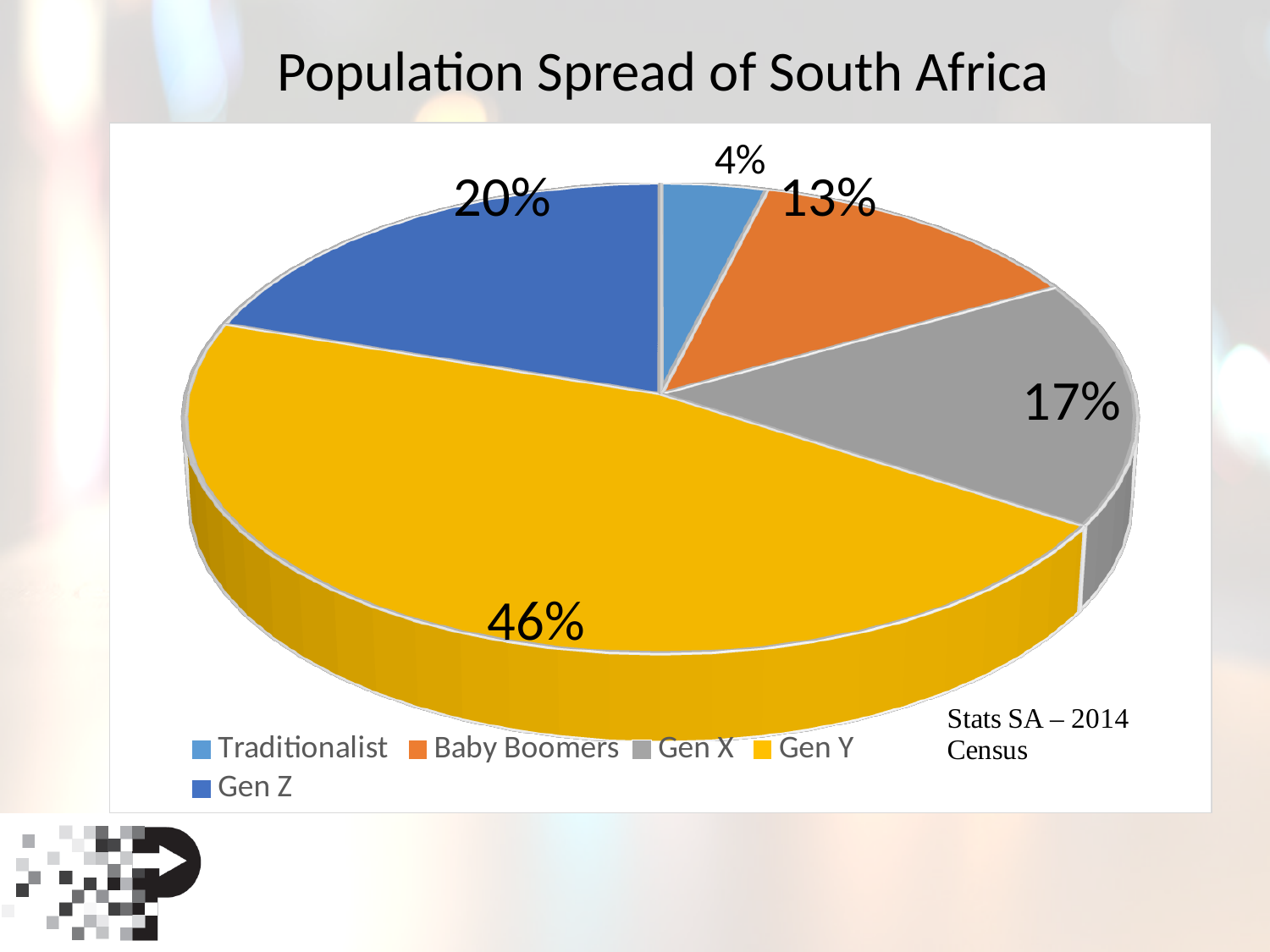
Which is larger, the share for Gen X or the share for Baby Boomers? Gen X What percentage of the population is Gen X? 17% What percentage of the population is Gen Y? 46% What is the title of the chart? Population Spread of South Africa What is the difference in percentage points between Gen Y and Gen Z? 26 Which generation has the largest share of the population? Gen Y What percentage of the population is Baby Boomers? 13% Which generation has the smallest share of the population? Traditionalist What percentage of the population is Gen Z? 20% What kind of chart is shown on the slide? pie chart What percentage of the population is Traditionalist? 4% How many categories does the pie chart show? 5